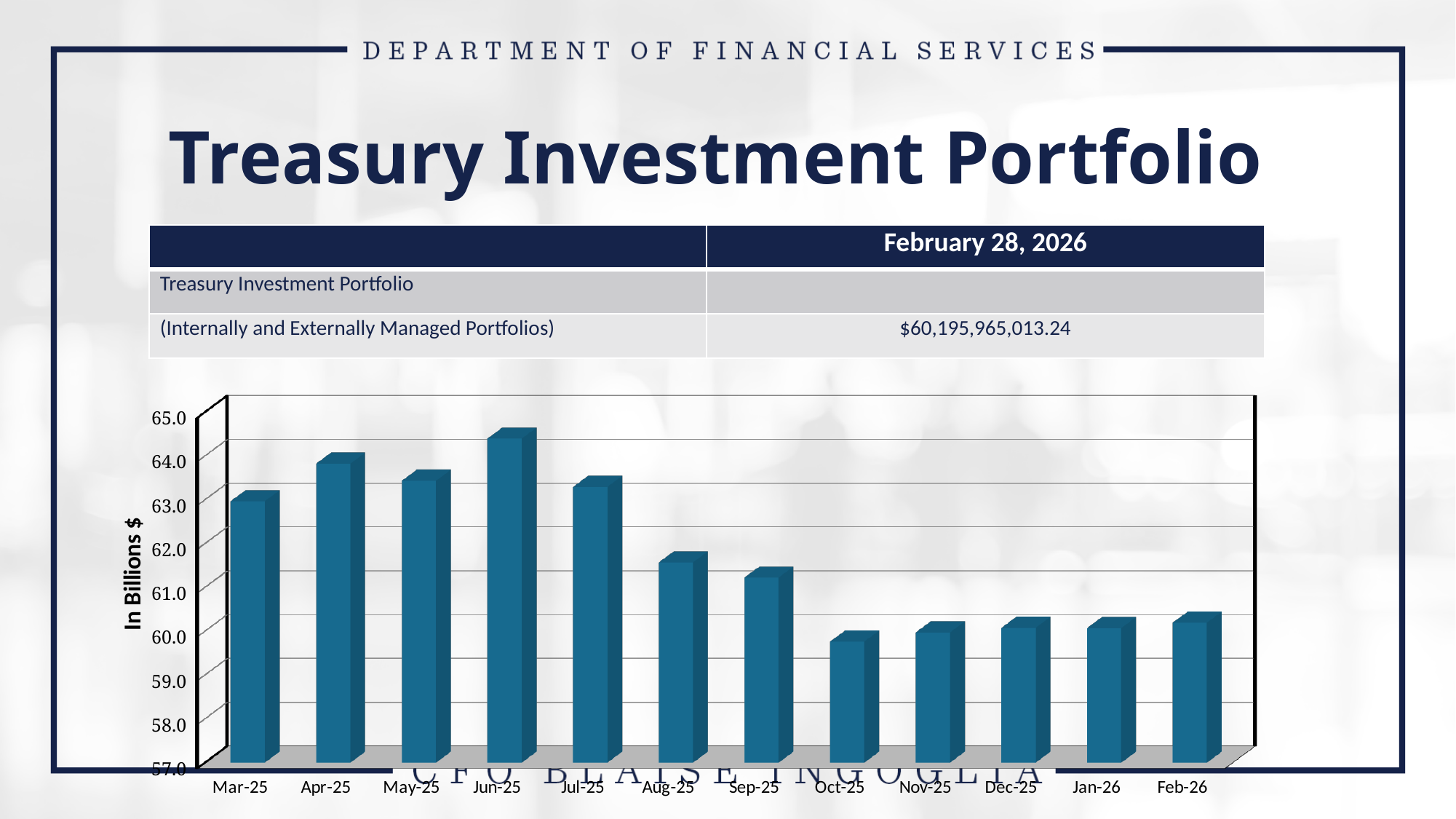
Overall, do the values rise or fall from Mar-25 to Feb-26? fall Which month has the highest value in the chart? Jun-25 Which is larger, the value for Jun-25 or the value for Jul-25? Jun-25 Is the value for Oct-25 greater or less than 60.0? less What is the label on the vertical axis of the chart? In Billions $ Is the value for Mar-25 greater or less than 62.0? greater Which month has the lowest value in the chart? Oct-25 What kind of chart is shown on the slide? bar chart Which is larger, the value for Apr-25 or the value for Mar-25? Apr-25 How many months are plotted on the x axis of the chart? 12 Is the value for Jun-25 greater or less than 64.0? greater